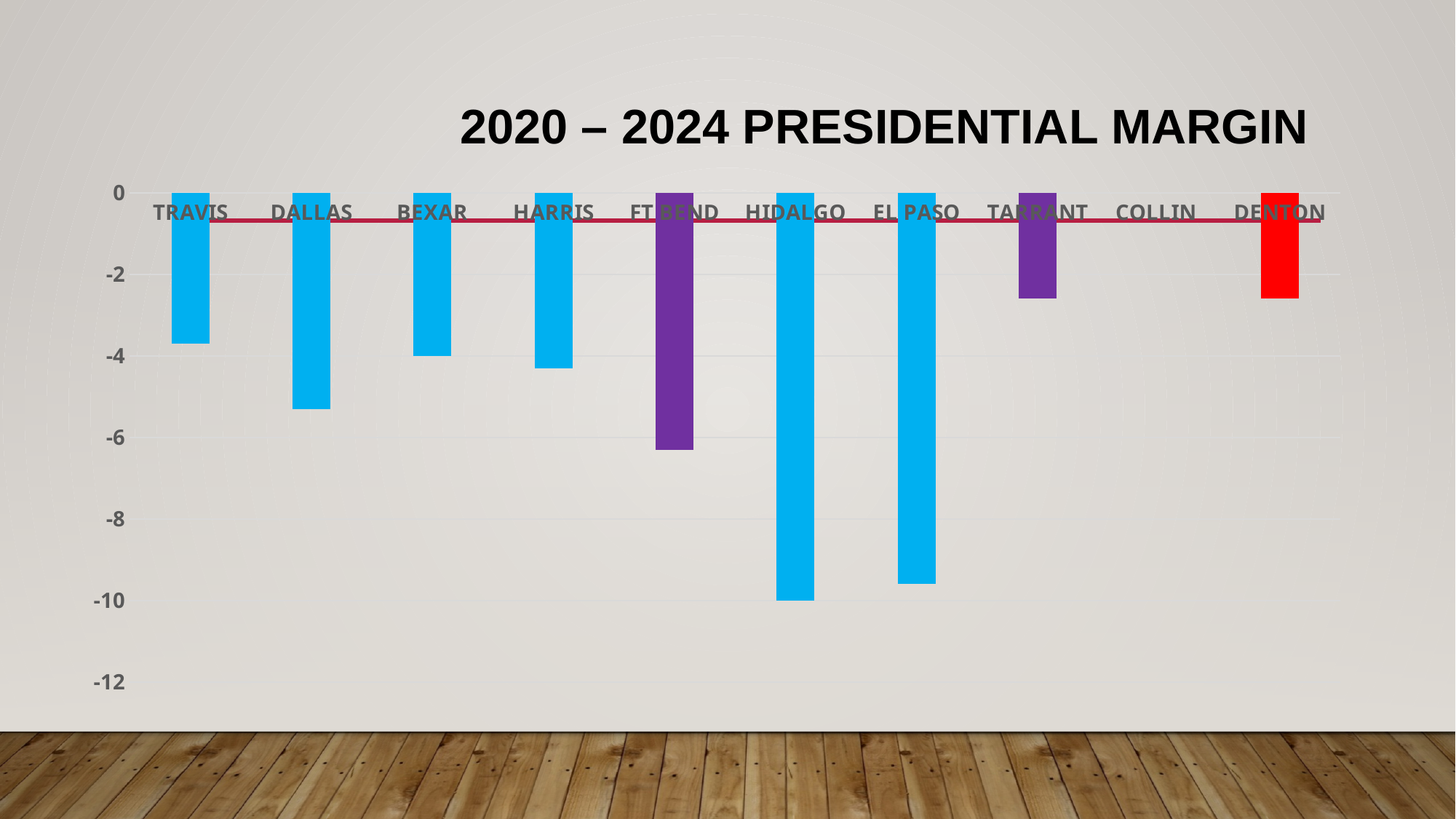
What is the title of the chart? 2020 – 2024 Presidential Margin Is the value for Travis greater or less than -4? greater Is the value for Ft Bend greater or less than -4? less Which county has the bar that extends furthest below zero? Hidalgo Is the value for Dallas greater or less than -4? less How many counties are listed along the x axis of the chart? 10 Which county has the more negative value, Dallas or Travis? Dallas What kind of chart is shown on the slide? bar chart What colour is the bar for Denton? red Which county has the more negative value, Ft Bend or Harris? Ft Bend